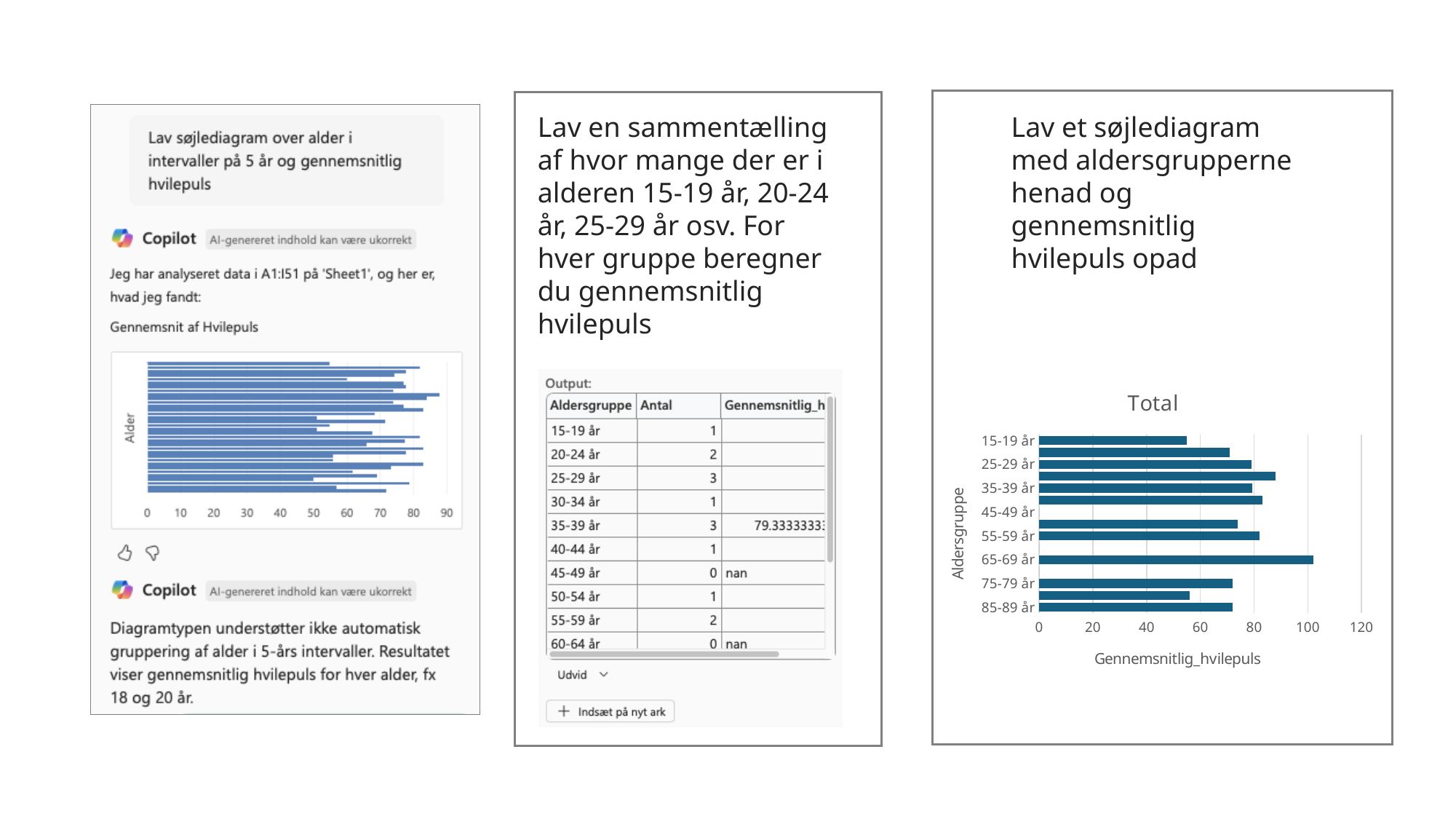
On the chart titled "Total" on the right, is the value for 15-19 år greater or less than 60? less On the chart titled "Total" on the right, is the value for 75-79 år greater or less than 60? greater On the chart titled "Total" on the right, what is the label of the horizontal axis? Gennemsnitlig_hvilepuls On the chart titled "Total" on the right, which is larger, the value for 35-39 år or the value for 15-19 år? 35-39 år On the chart titled "Total" on the right, which is larger, the value for 75-79 år or the value for 65-69 år? 65-69 år What is the title of the bar chart on the right of the slide? Total On the chart titled "Total" on the right, is the value for 65-69 år greater or less than 80? greater What kind of chart is shown in the Copilot screenshot on the left of the slide? bar chart On the chart titled "Total" on the right, what kind of chart is shown? bar chart On the chart titled "Total" on the right, which age group has the highest average resting pulse? 65-69 år On the chart titled "Total" on the right, which is larger, the value for 65-69 år or the value for 15-19 år? 65-69 år